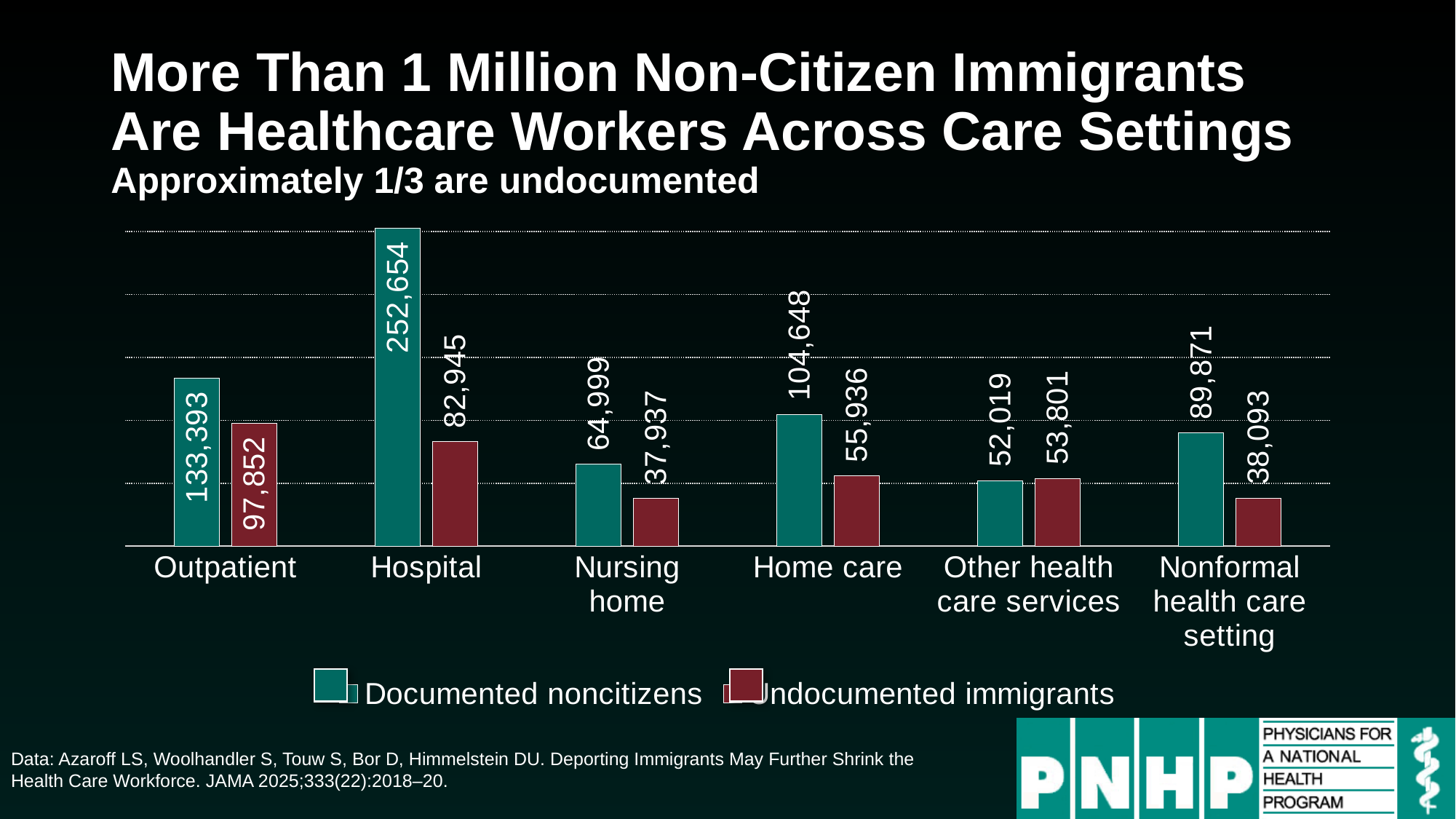
What colour are the bars for Undocumented immigrants? Dark red Which category has the lowest value for Undocumented immigrants? Nursing home What kind of chart is shown on the slide? Bar chart Which is larger in the Other health care services category: Documented noncitizens or Undocumented immigrants? Undocumented immigrants What is the difference between Documented noncitizens and Undocumented immigrants in the Home care category? 48,712 How many categories are shown on the x axis? 6 What is the value for Undocumented immigrants in the Outpatient category? 97,852 How many series does the legend list? 2 What is the value for Documented noncitizens in the Hospital category? 252,654 Which category has the highest value for Documented noncitizens? Hospital What is the value for Documented noncitizens in the Nonformal health care setting category? 89,871 What is the value for Undocumented immigrants in the Nursing home category? 37,937